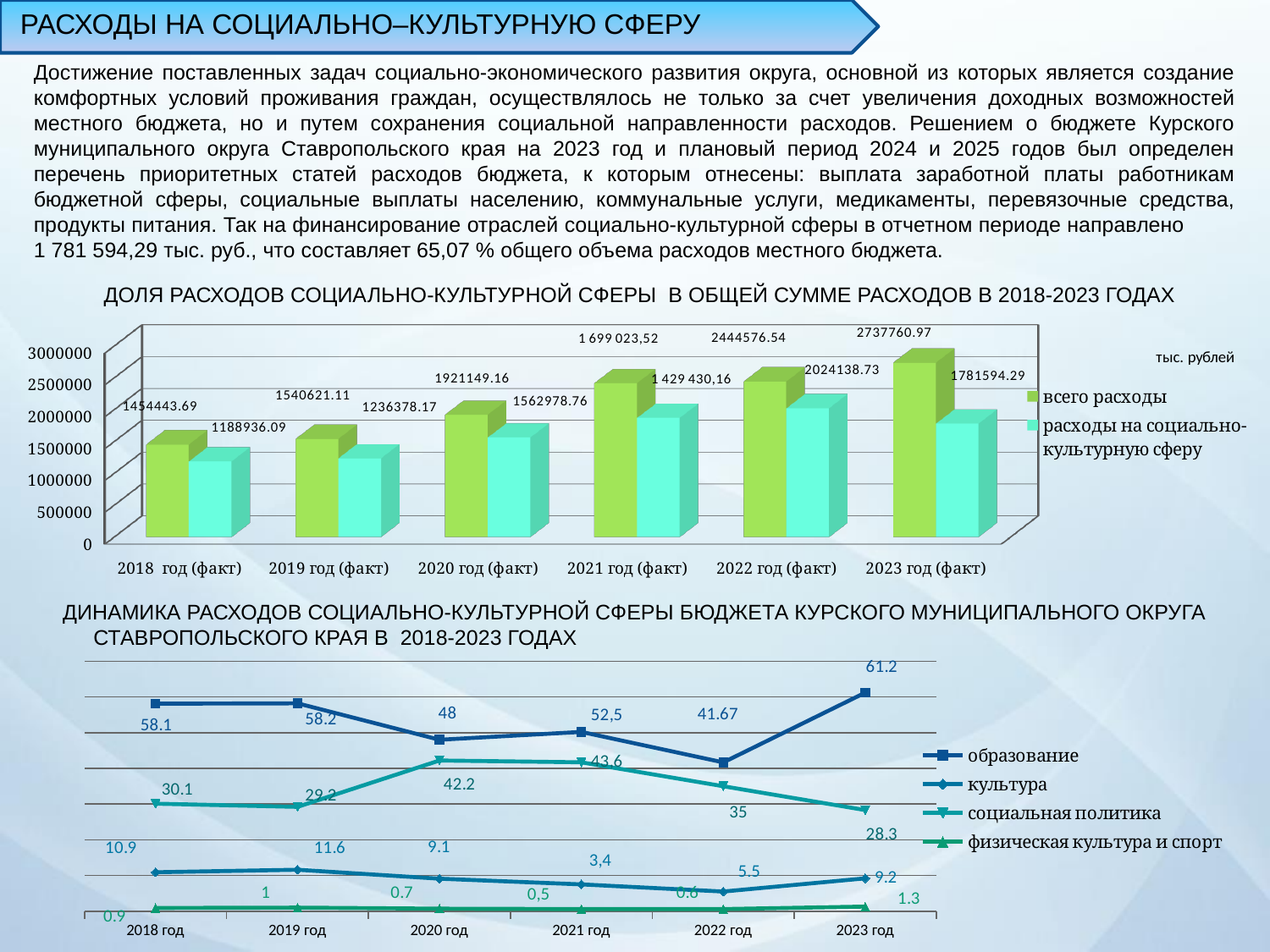
In the top chart, which year has the highest value for 'всего расходы'? 2023 год (факт) In the bottom chart (ДИНАМИКА РАСХОДОВ...), what is the value for 'образование' in 2022 год? 41.67 In the top chart (ДОЛЯ РАСХОДОВ СОЦИАЛЬНО-КУЛЬТУРНОЙ СФЕРЫ...), what is the value of 'всего расходы' for 2023 год (факт)? 2737760.97 What kind of chart is the top chart? Bar chart In the top chart, how many series does the legend list? 2 In the bottom chart, which is larger in 2021 год: 'образование' or 'социальная политика'? образование In the top chart, which year has the lowest value for 'расходы на социально-культурную сферу'? 2018 год (факт) In the top chart, what is the difference between 'всего расходы' and 'расходы на социально-культурную сферу' for 2023 год (факт)? 956166.68 In the bottom chart, does the value for 'социальная политика' rise or fall from 2021 год to 2023 год? Fall In the top chart, what is the value of 'расходы на социально-культурную сферу' for 2020 год (факт)? 1562978.76 In the bottom chart, how many series does the legend list? 4